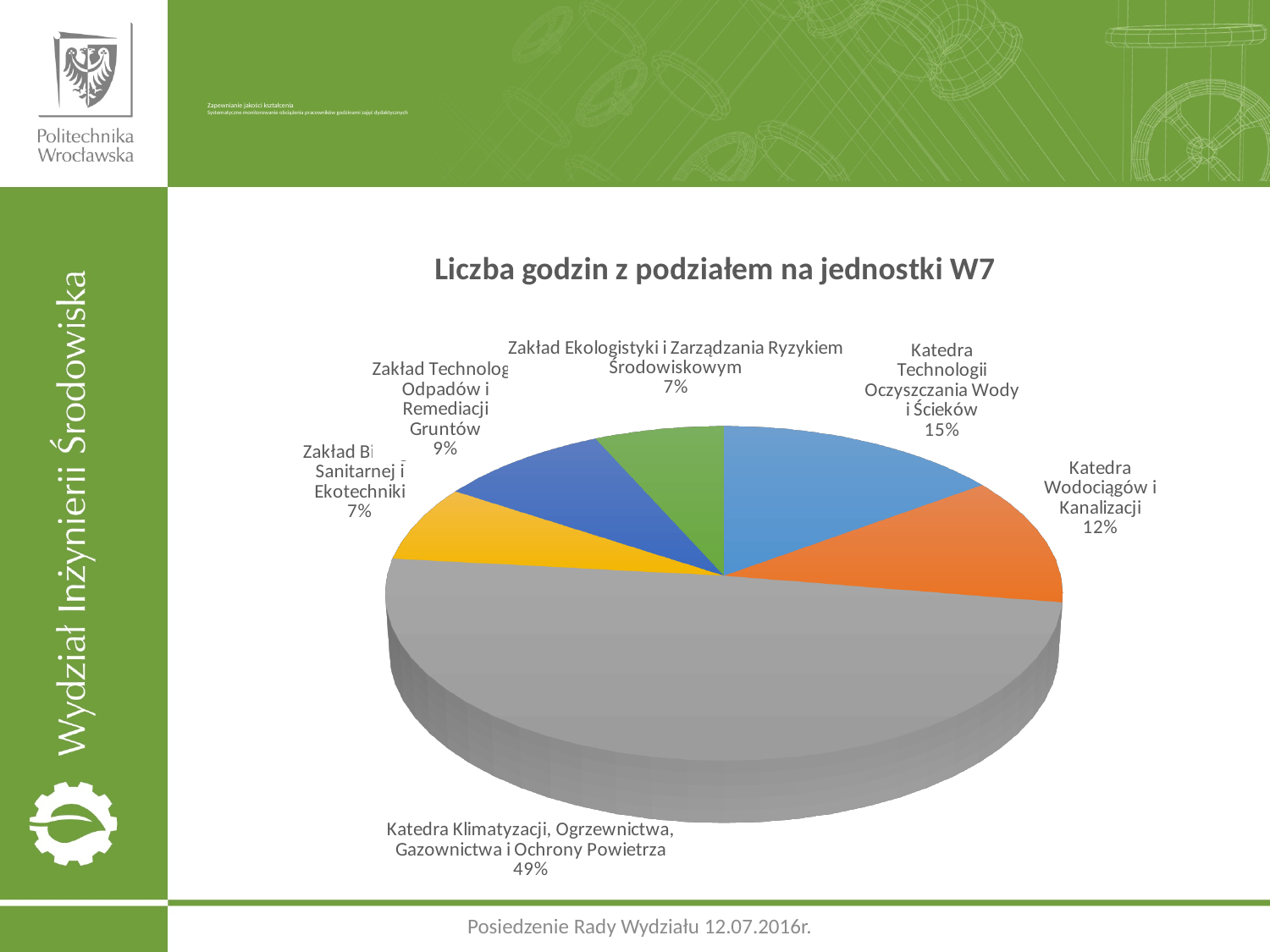
What share of the pie does Katedra Klimatyzacji, Ogrzewnictwa, Gazownictwa i Ochrony Powietrza have? 49% What is the value shown for Katedra Technologii Oczyszczania Wody i Ścieków? 15% Which is larger: the share of Katedra Technologii Oczyszczania Wody i Ścieków or Katedra Wodociągów i Kanalizacji? Katedra Technologii Oczyszczania Wody i Ścieków What is the difference in percentage points between Katedra Technologii Oczyszczania Wody i Ścieków and Katedra Wodociągów i Kanalizacji? 3% What is the value shown for Katedra Wodociągów i Kanalizacji? 12% How many slices does the pie chart have? 6 Which unit has the largest share of the pie? Katedra Klimatyzacji, Ogrzewnictwa, Gazownictwa i Ochrony Powietrza What is the title of the chart? Liczba godzin z podziałem na jednostki W7 What kind of chart is shown on the slide? Pie chart What is the value shown for Zakład Ekologistyki i Zarządzania Ryzykiem Środowiskowym? 7% What is the difference in percentage points between Katedra Klimatyzacji, Ogrzewnictwa, Gazownictwa i Ochrony Powietrza and Katedra Technologii Oczyszczania Wody i Ścieków? 34% What colour is the slice for Katedra Klimatyzacji, Ogrzewnictwa, Gazownictwa i Ochrony Powietrza? Grey